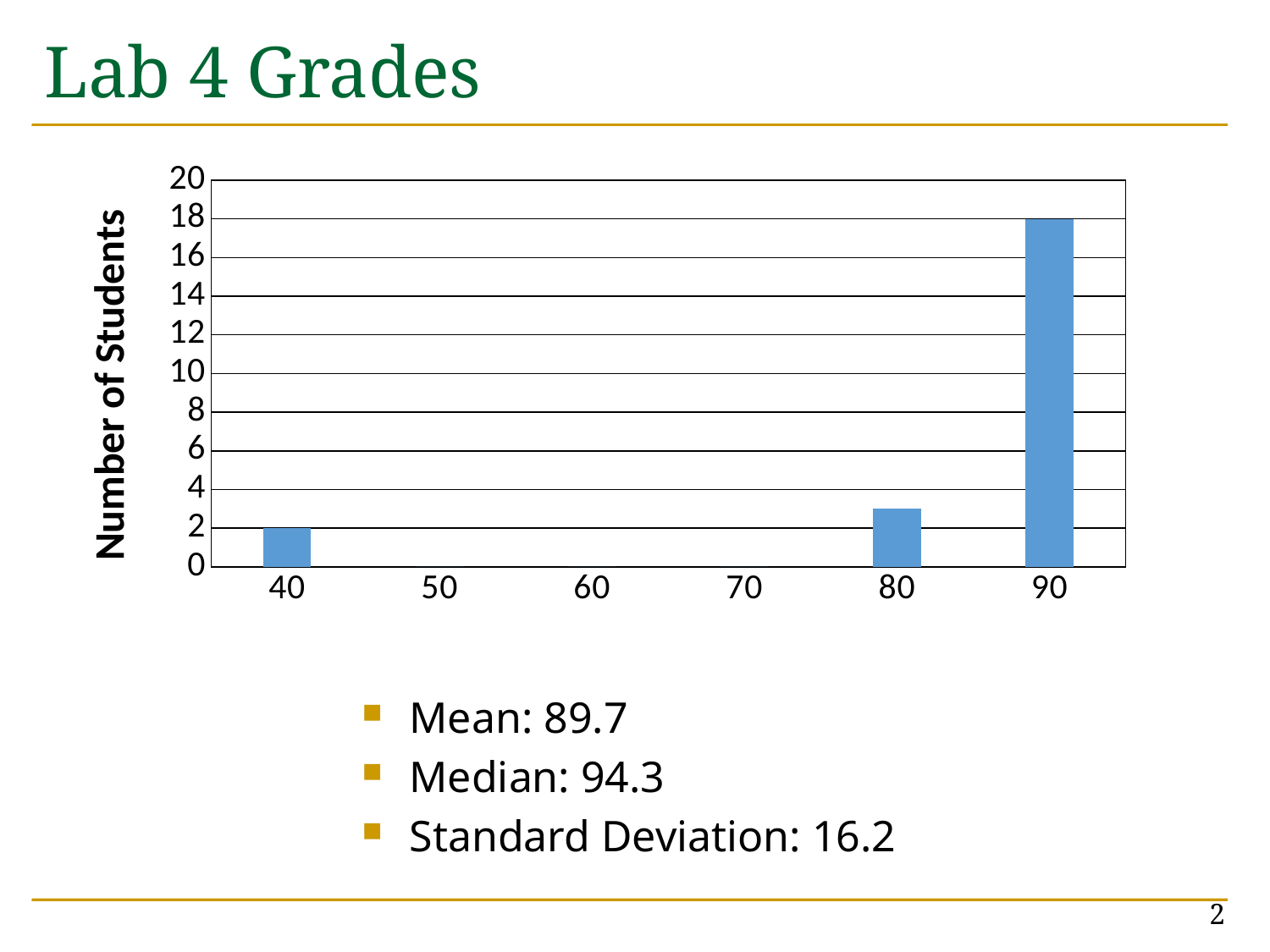
How many students are shown for the 90 grade bin? 18 How many students are shown for the 40 grade bin? 2 What is the title of the slide containing the chart? Lab 4 Grades What is the difference in number of students between the 90 bin and the 40 bin? 16 How many grade bins are labelled on the x axis? 6 What kind of chart is shown on the slide? bar chart Which has more students, the 40 bin or the 80 bin? 80 Is the number of students in the 80 bin greater or less than 4? less Is the number of students in the 90 bin greater or less than 10? greater What is the label of the vertical axis? Number of Students Is the number of students in the 80 bin greater or less than 2? greater Which grade bin has the tallest bar? 90